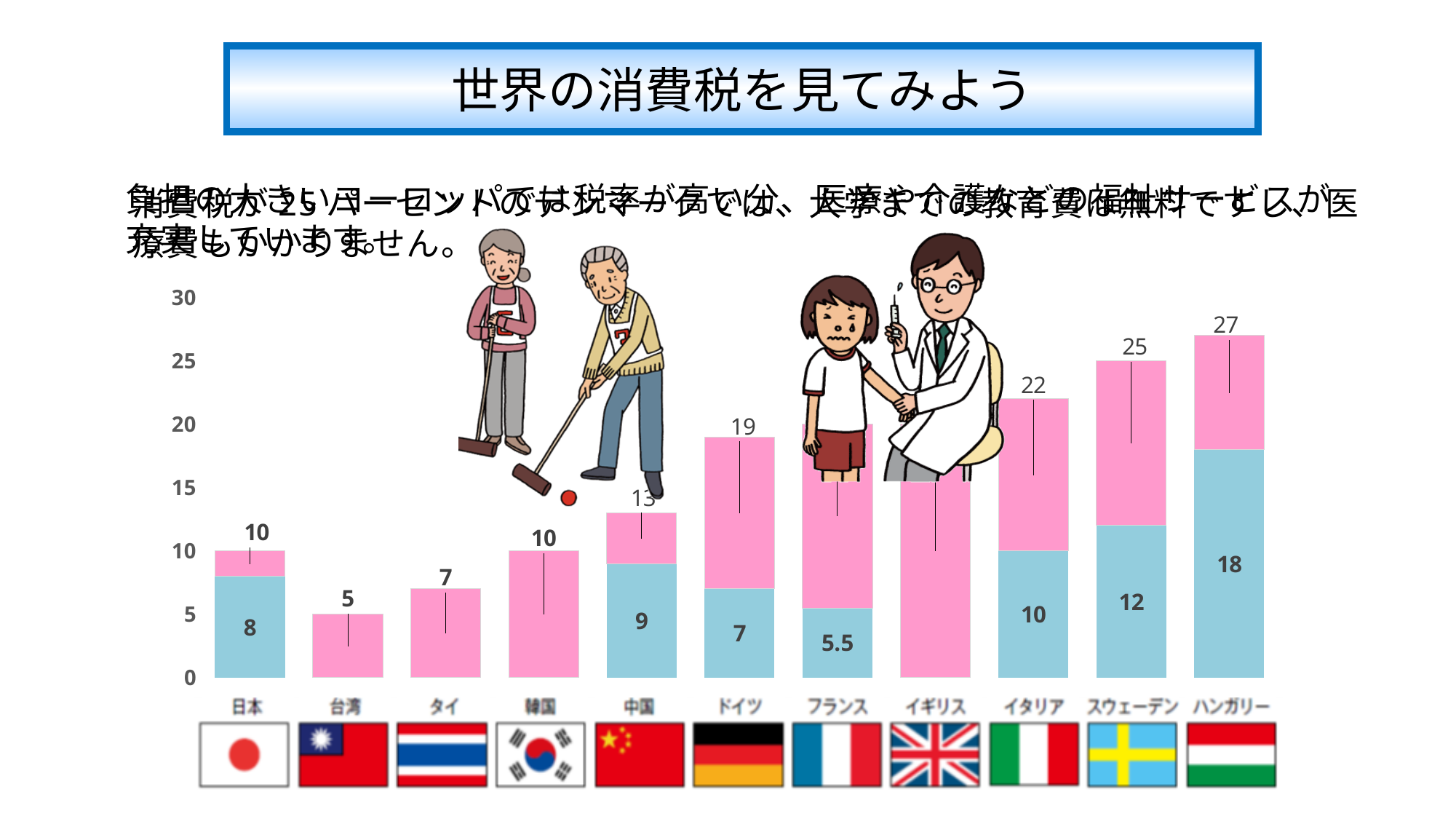
What type of chart is shown on the slide? bar chart What is the value of the light blue bar for フランス? 5.5 What is the value of the pink bar for 日本? 10 What is the value of the light blue bar for ハンガリー? 18 How many countries are shown on the x axis of the chart? 11 What is the value of the pink bar for ドイツ? 19 What is the title of the slide? 世界の消費税を見てみよう What is the difference between the pink bar values for ハンガリー and スウェーデン? 2 Which has a higher pink bar value, ドイツ or 中国? ドイツ Which country has the lowest pink bar? 台湾 Is the value of the pink bar for フランス greater or less than 15? greater Which country has the highest pink bar? ハンガリー